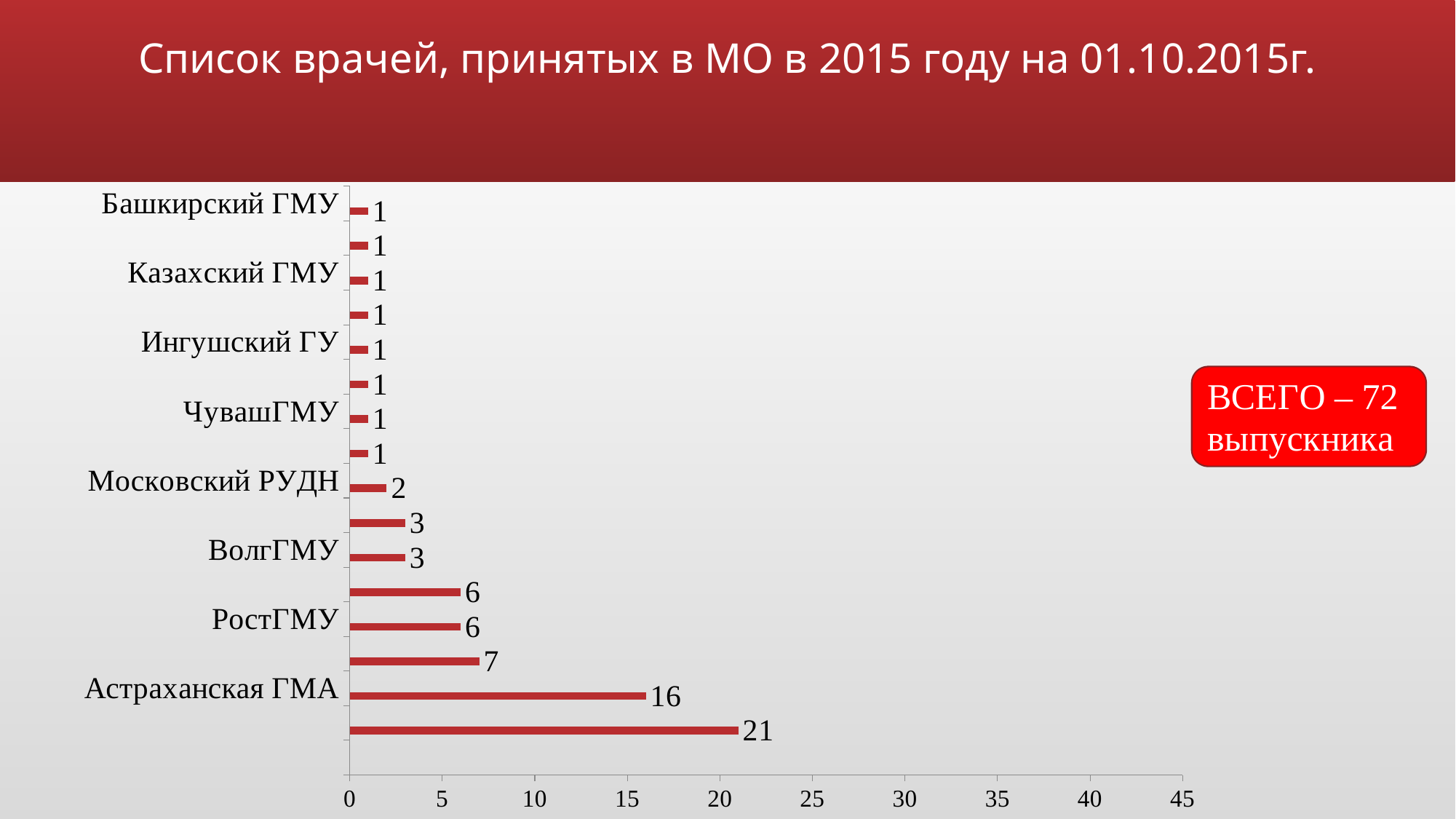
What total number of graduates is stated in the red box on the slide? 72 What kind of chart is shown on the slide? bar chart What is the value for ВолгГМУ? 3 Which is larger, the value for Астраханская ГМА or the value for РостГМУ? Астраханская ГМА What is the largest value labelled on the chart? 21 What is the difference between the values for ВолгГМУ and Московский РУДН? 1 What is the value for Астраханская ГМА? 16 How many bars are plotted on the chart? 16 What is the value for Башкирский ГМУ? 1 What is the difference between the values for Астраханская ГМА and РостГМУ? 10 What is the value for РостГМУ? 6 What is the value for Московский РУДН? 2